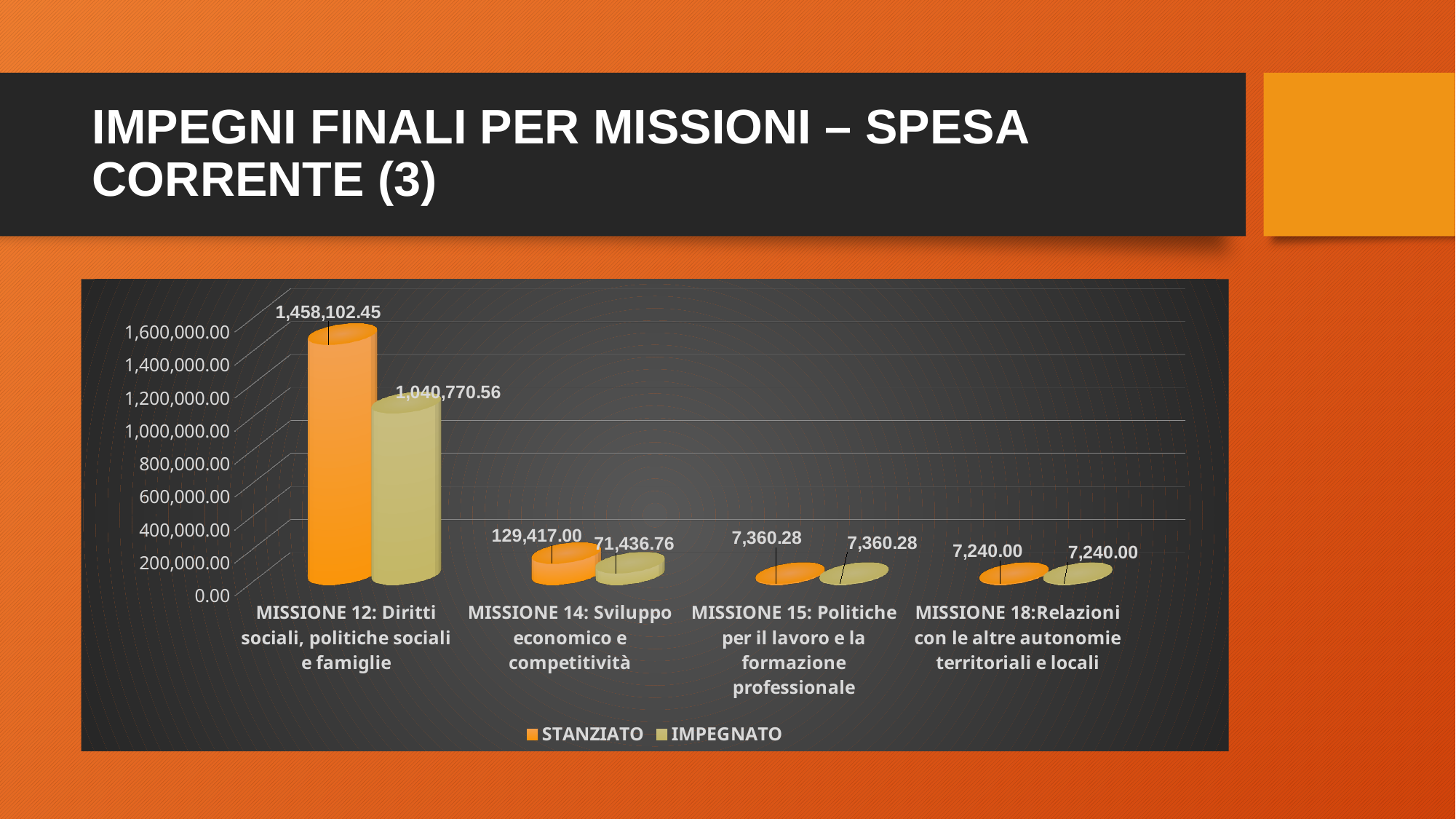
What is the difference between the STANZIATO and IMPEGNATO values for MISSIONE 12? 417,331.89 Which mission has the highest STANZIATO value? MISSIONE 12: Diritti sociali, politiche sociali e famiglie Which is larger for MISSIONE 14: the STANZIATO value or the IMPEGNATO value? STANZIATO What is the STANZIATO value for MISSIONE 15: Politiche per il lavoro e la formazione professionale? 7,360.28 What is the IMPEGNATO value for MISSIONE 12: Diritti sociali, politiche sociali e famiglie? 1,040,770.56 How many missions (categories) are shown on the x axis? 4 What kind of chart is shown on the slide? Bar chart What is the STANZIATO value for MISSIONE 12: Diritti sociali, politiche sociali e famiglie? 1,458,102.45 What is the difference between the STANZIATO and IMPEGNATO values for MISSIONE 14: Sviluppo economico e competitività? 57,980.24 Which mission has the lowest IMPEGNATO value? MISSIONE 18:Relazioni con le altre autonomie territoriali e locali How many series does the legend list? 2 What is the IMPEGNATO value for MISSIONE 14: Sviluppo economico e competitività? 71,436.76